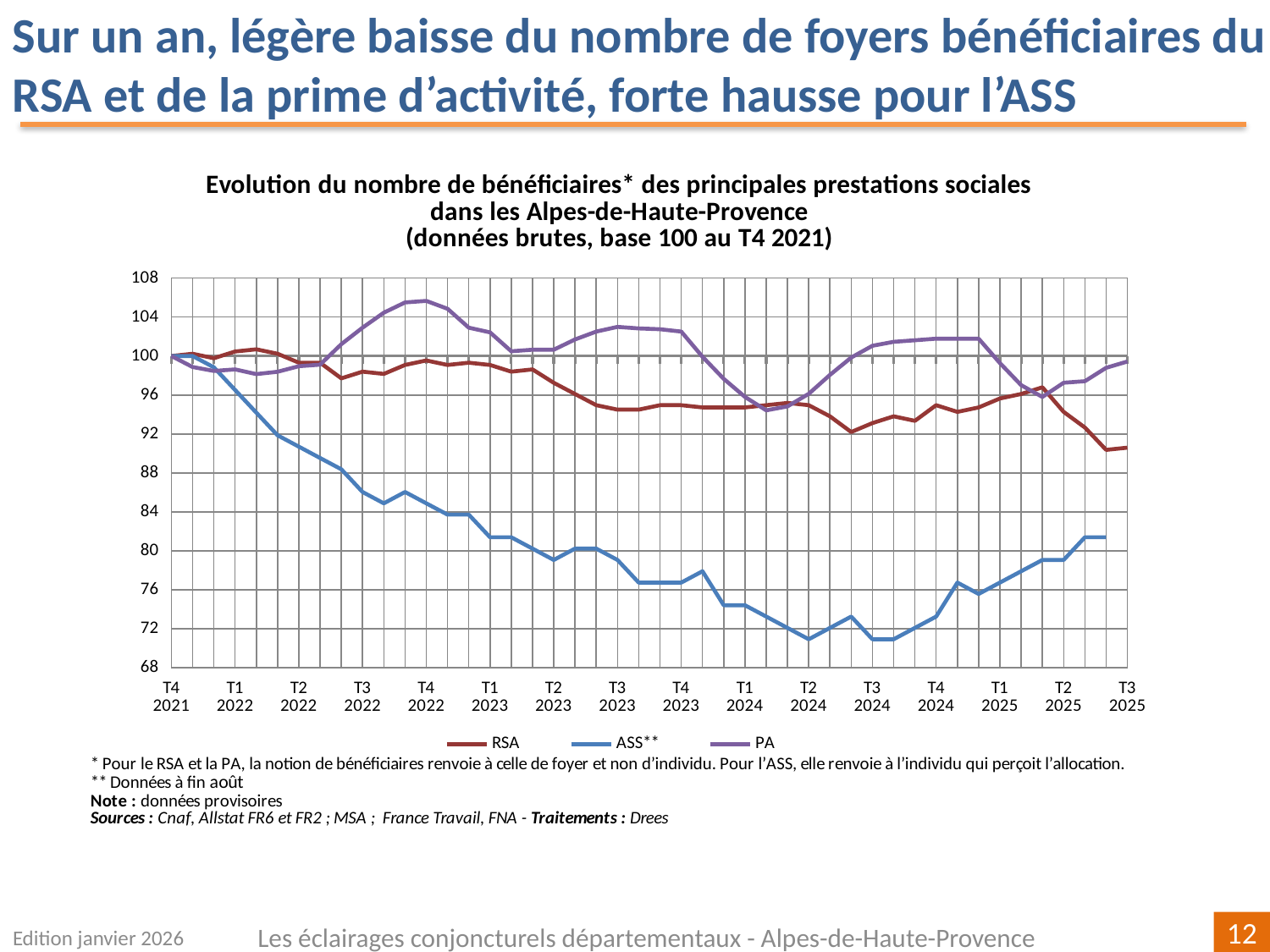
How many series does the legend list? 3 How many quarter labels are shown on the x axis? 16 What are the three series named in the legend? RSA, ASS** and PA Is the value of the RSA series at T3 2025 greater or less than 92? less What is the value of the RSA series at T4 2021? 100 Is the value of the ASS** series at T1 2024 greater or less than 76? less At T3 2025, which series is higher, PA or RSA? PA Is the value of the PA series at T4 2022 greater or less than 104? greater Does the ASS** series rise or fall between T4 2021 and T2 2024? fall Which series has the highest value at T4 2022? PA What kind of chart is shown on the slide? line chart